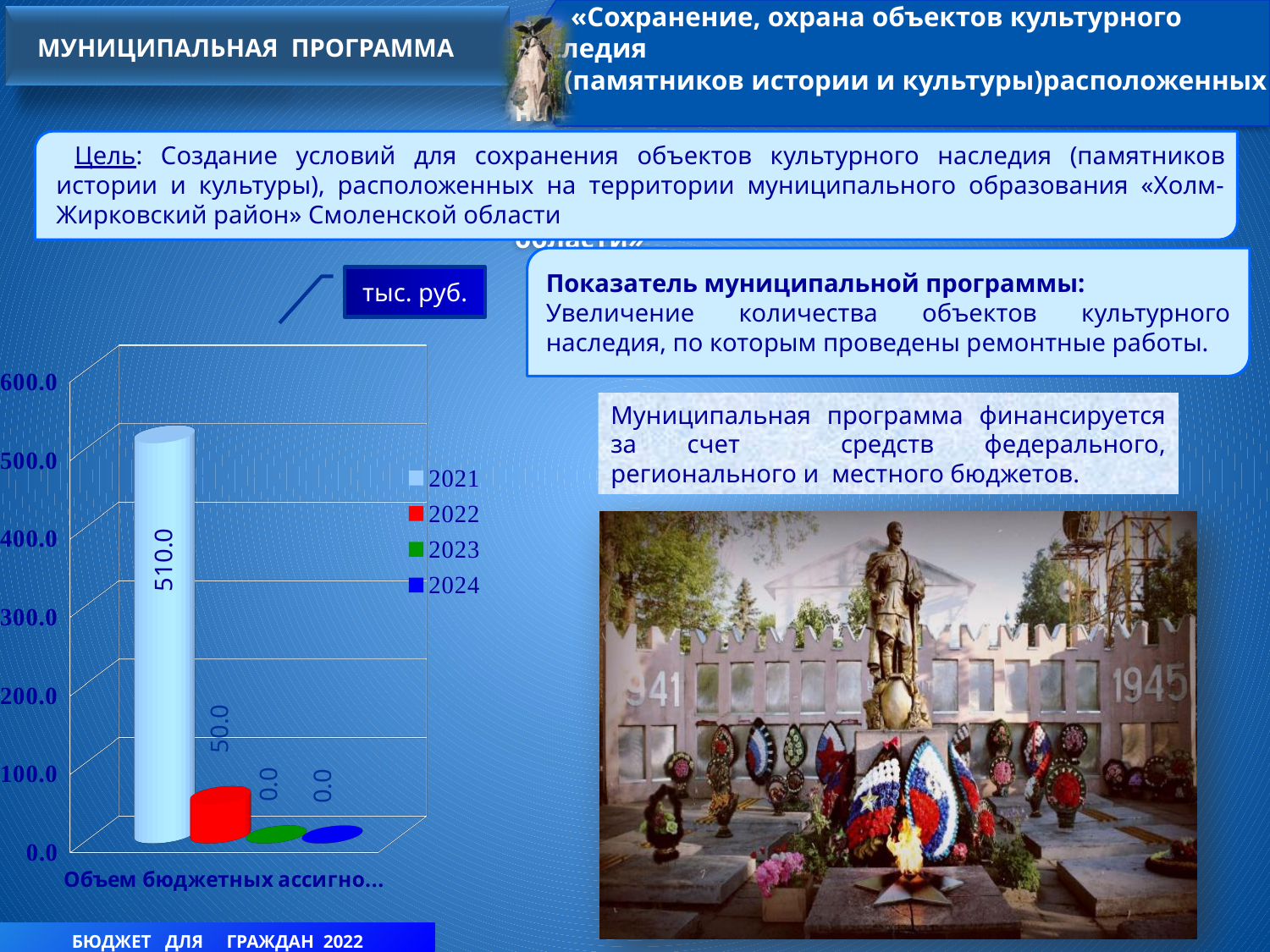
What is the value for 2022 on the chart? 50.0 What is the value for 2021 on the chart? 510.0 How many series does the legend list? 4 What unit of measurement is indicated for the chart values? тыс. руб. What kind of chart is shown on the slide? bar chart Is the value for 2022 greater or less than 100.0? less What is the value for 2023 on the chart? 0.0 Which is larger, the value for 2021 or the value for 2022? 2021 Which year has the highest value on the chart? 2021 What is the difference between the values for 2021 and 2022? 460.0 What is the value for 2024 on the chart? 0.0 Is the value for 2021 greater or less than 500.0? greater